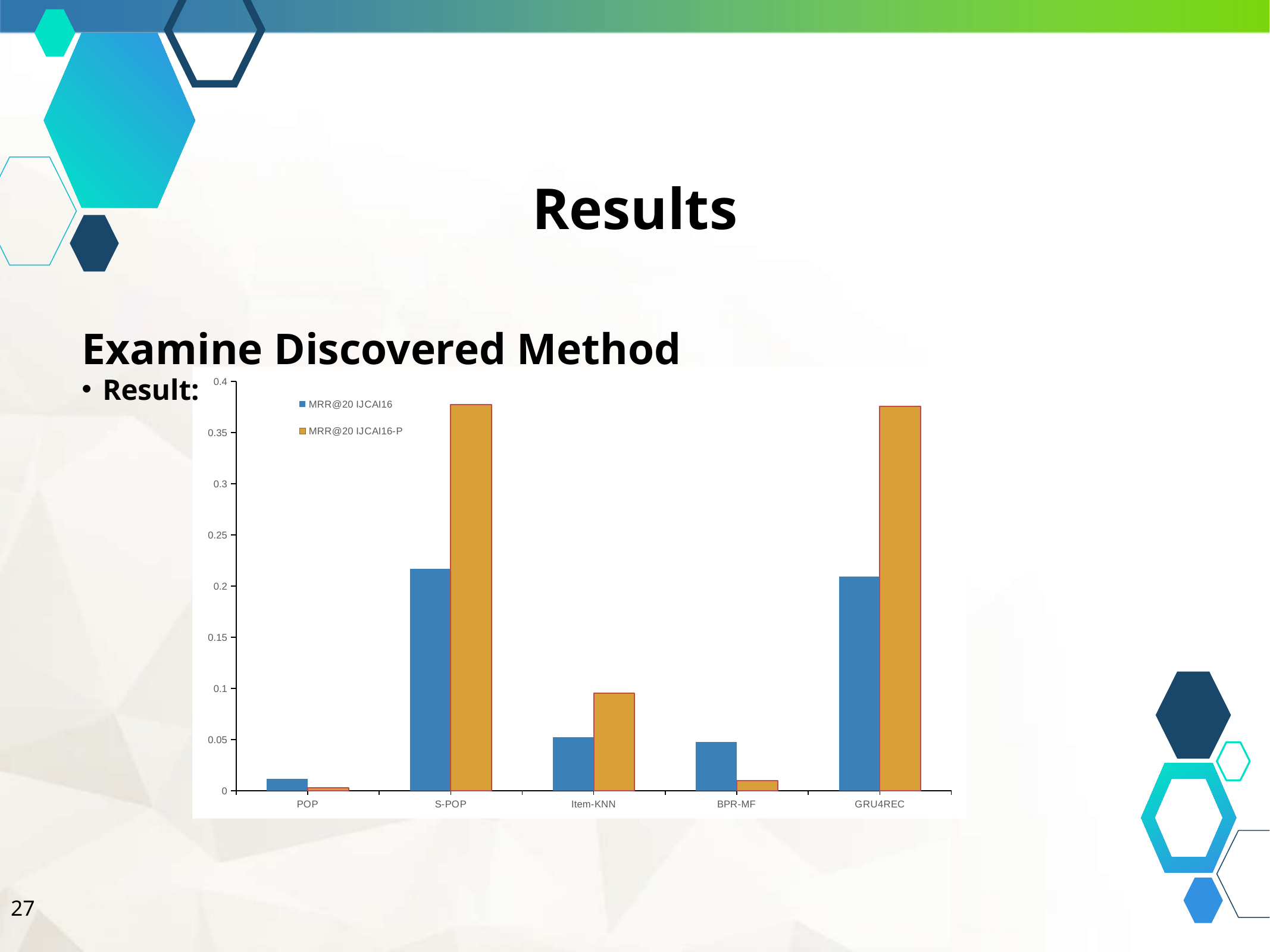
Which method has the lowest MRR@20 IJCAI16 value? POP Is the MRR@20 IJCAI16 value for GRU4REC greater or less than 0.2? greater Which method has the lowest MRR@20 IJCAI16-P value? POP For BPR-MF, which series has the larger value: MRR@20 IJCAI16 or MRR@20 IJCAI16-P? MRR@20 IJCAI16 Is the MRR@20 IJCAI16-P value for BPR-MF greater or less than 0.05? less For Item-KNN, which series has the larger value: MRR@20 IJCAI16 or MRR@20 IJCAI16-P? MRR@20 IJCAI16-P What kind of chart is shown on the slide? bar chart Is the MRR@20 IJCAI16-P value for S-POP greater or less than 0.35? greater How many series does the chart's legend list? 2 How many methods (categories) are shown on the x axis of the chart? 5 Which colour represents the MRR@20 IJCAI16-P series in the chart? orange